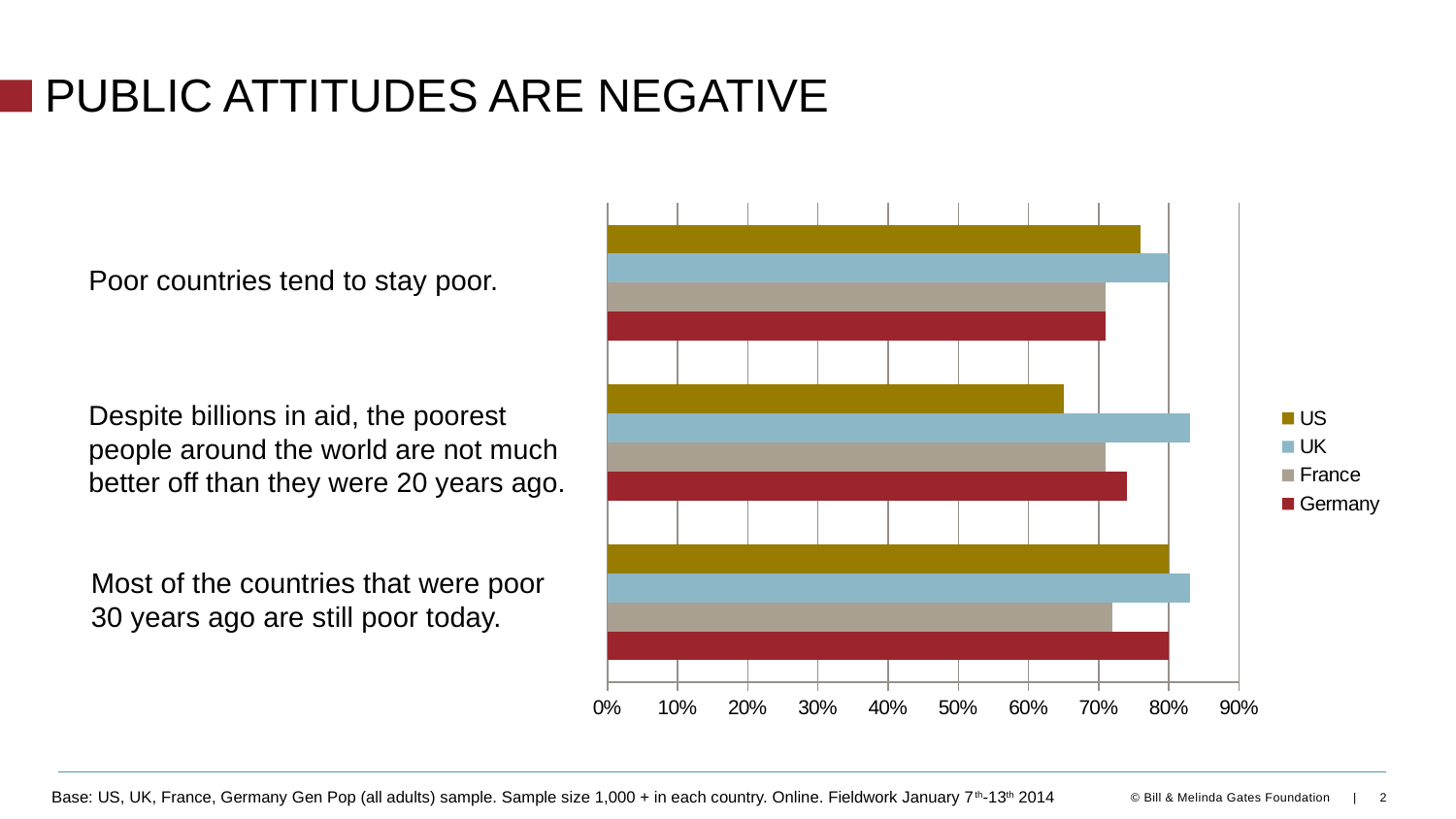
For the statement "Most of the countries that were poor 30 years ago are still poor today", which country has the lowest value? France For the statement "Despite billions in aid, the poorest people around the world are not much better off than they were 20 years ago", which country has the lowest value? US What kind of chart is shown on the slide? Bar chart For the statement "Poor countries tend to stay poor", which is larger, the UK value or the France value? UK How many series does the chart's legend list? 4 Is the Germany value for "Most of the countries that were poor 30 years ago are still poor today" greater or less than 70%? greater Is the France value for "Poor countries tend to stay poor" greater or less than 80%? less Is the UK value for "Despite billions in aid, the poorest people around the world are not much better off than they were 20 years ago" greater or less than 80%? greater For the statement "Despite billions in aid, the poorest people around the world are not much better off than they were 20 years ago", which country has the highest value? UK How many statements (categories) are plotted in the chart? 3 Which countries are listed in the chart's legend? US, UK, France, Germany